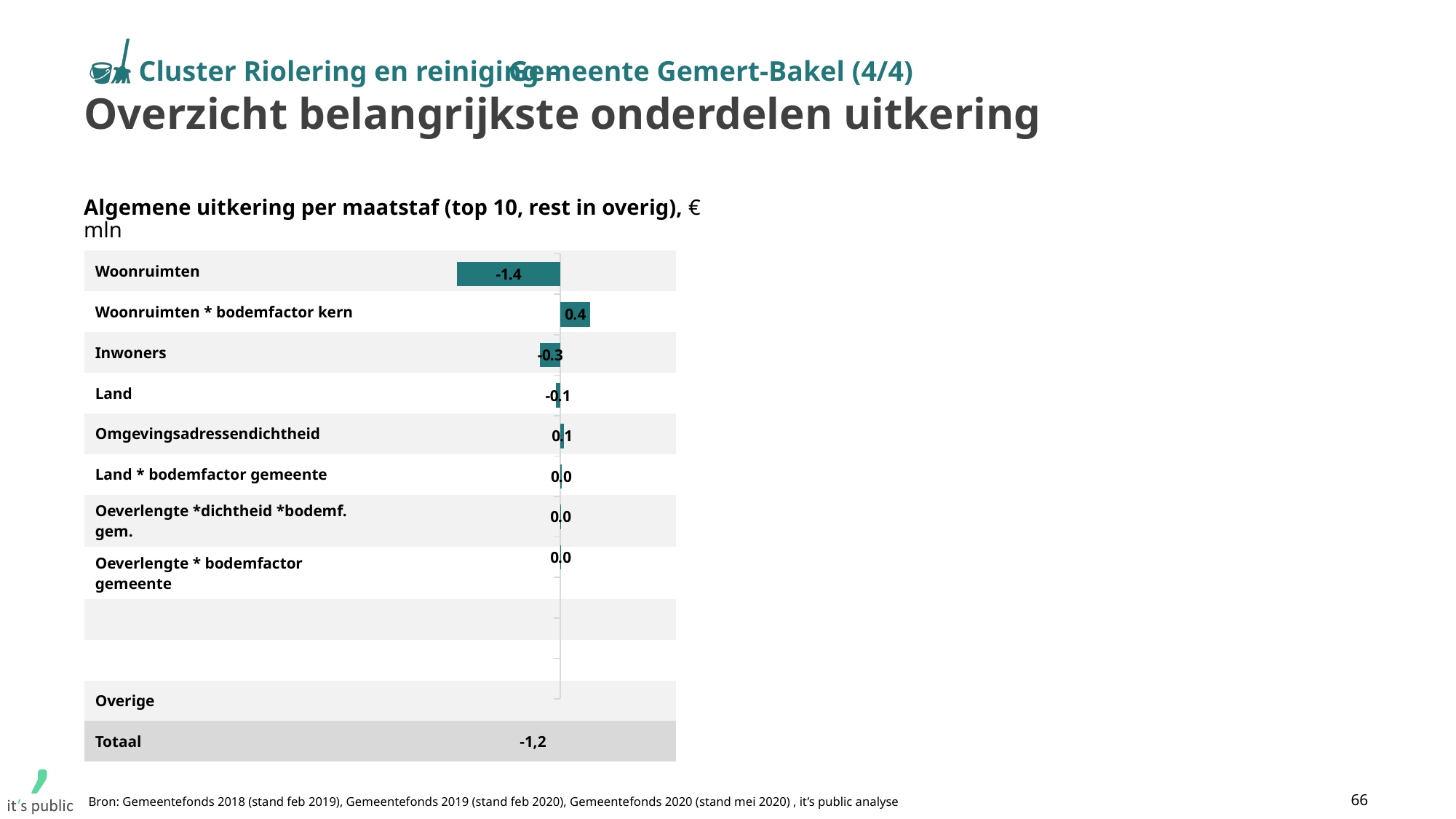
What is the value for Woonruimten? -1.4 What kind of chart is shown on the slide? Bar chart What unit is stated in the chart title? € mln What is the value for Omgevingsadressendichtheid? 0.1 Which category has the highest value? Woonruimten * bodemfactor kern What is the value for Woonruimten * bodemfactor kern? 0.4 What is the value shown for Totaal? -1,2 Which category has the lowest (most negative) value? Woonruimten What is the value for Inwoners? -0.3 Which is larger, the value for Omgevingsadressendichtheid or the value for Land? Omgevingsadressendichtheid What is the value for Land? -0.1 What is the difference between the values for Woonruimten * bodemfactor kern and Inwoners? 0.7